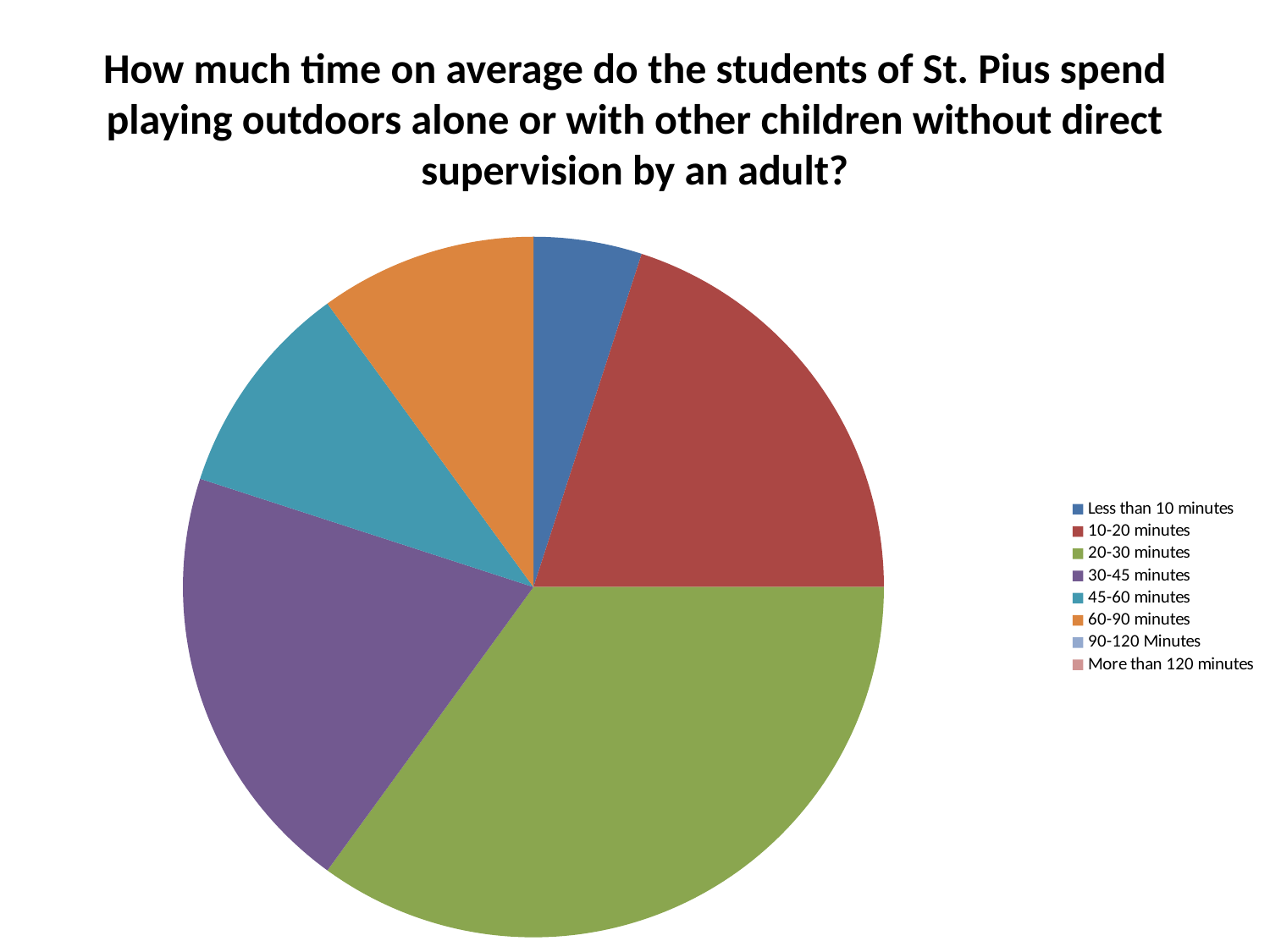
Is the share of the 20-30 minutes slice greater or less than half of the pie? less Which slice is larger, 30-45 minutes or 60-90 minutes? 30-45 minutes What kind of chart is shown on the slide? pie chart Which slice is larger, Less than 10 minutes or 45-60 minutes? 45-60 minutes Which slice is larger, 20-30 minutes or 10-20 minutes? 20-30 minutes Which category has the largest slice of the pie? 20-30 minutes Which legend entry is listed first? Less than 10 minutes How many slices are visible in the pie? 6 What colour is the 20-30 minutes slice? green How many entries does the legend list? 8